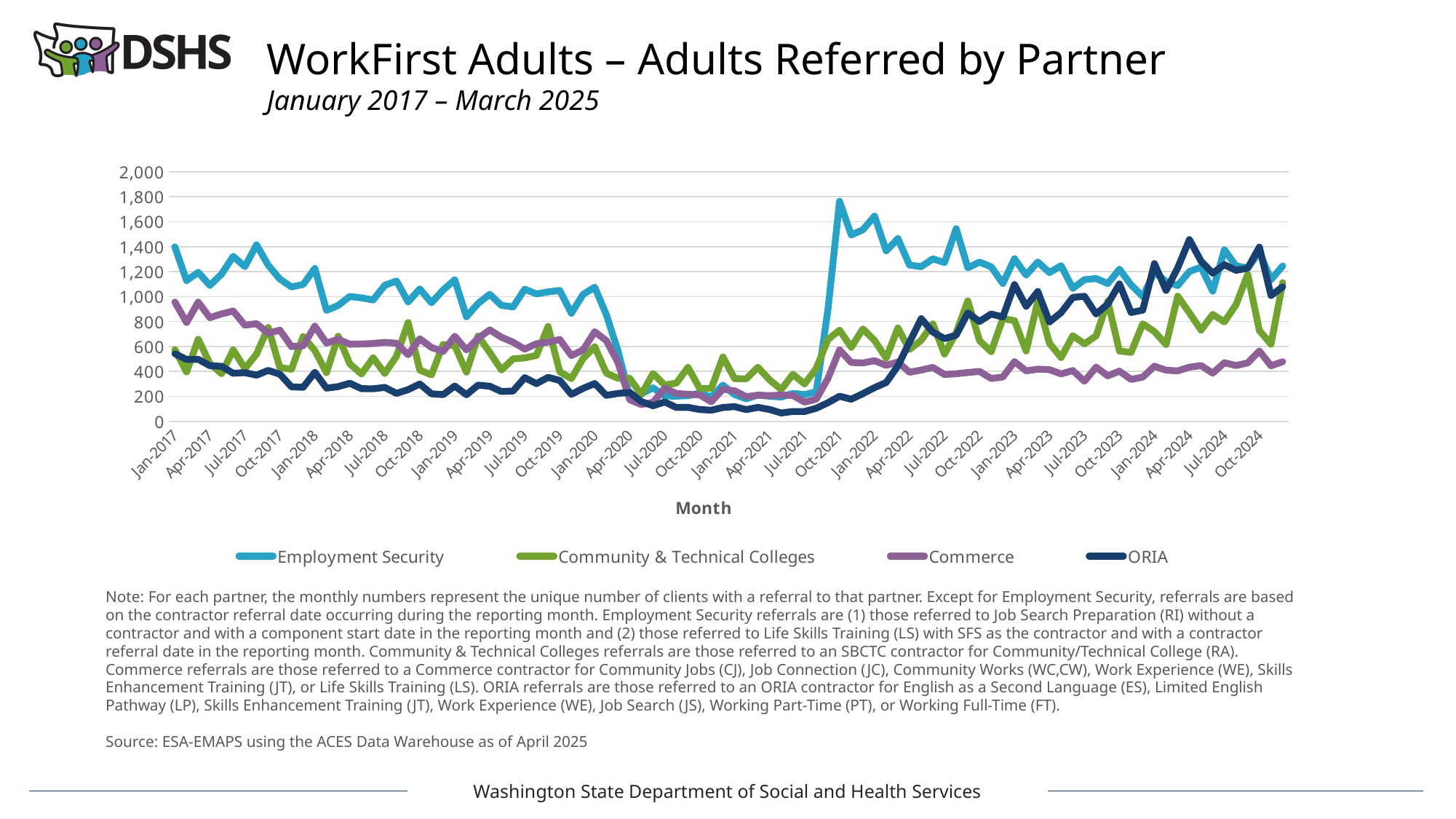
In Oct-2024, which is larger: ORIA or Commerce? ORIA Does the ORIA series rise or fall overall from Jan-2022 to Oct-2024? Rise Is the value for Employment Security in Jan-2017 greater or less than 1,200? greater Which series reaches the highest value anywhere on the chart? Employment Security What kind of chart is shown on the slide? Line chart What is the label of the x axis? Month Which series is shown in purple in the legend? Commerce Is the value for Employment Security in Jul-2020 greater or less than 400? less In Jan-2017, which is larger: Employment Security or ORIA? Employment Security Is the value for ORIA in Jul-2021 greater or less than 200? less How many series does the legend list? 4